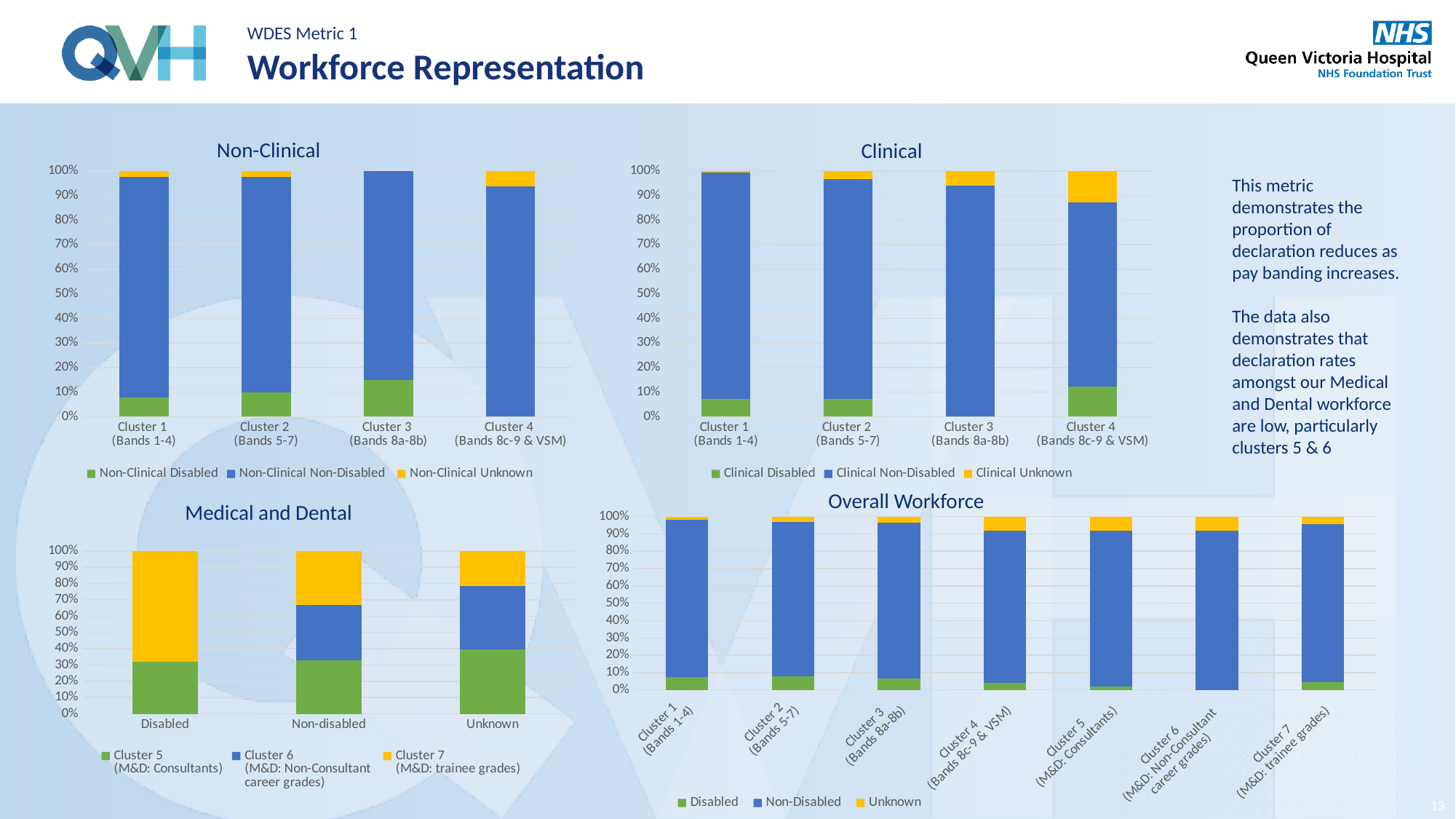
How many categories are shown on the x axis of the Medical and Dental chart? 3 How many clusters are shown on the x axis of the Non-Clinical chart? 4 In the Medical and Dental chart, is the Cluster 5 (M&D: Consultants) value larger for the Disabled category or the Unknown category? Unknown In the Non-Clinical chart, is the Non-Clinical Disabled value for Cluster 3 (Bands 8a-8b) greater or less than 10%? greater In the Clinical chart, does the Clinical Non-Disabled share rise or fall from Cluster 1 to Cluster 4? fall What kind of chart is the Non-Clinical chart? Stacked bar chart In the Clinical chart, which cluster has the largest Clinical Unknown share? Cluster 4 (Bands 8c-9 & VSM) In the Medical and Dental chart, is the Cluster 5 (M&D: Consultants) value for the Unknown category greater or less than 50%? less How many clusters are shown on the x axis of the Overall Workforce chart? 7 How many series does the legend of the Clinical chart list? 3 In the Overall Workforce chart, what colour represents the Unknown series? Yellow In the Non-Clinical chart, which cluster has the largest Non-Clinical Disabled share? Cluster 3 (Bands 8a-8b)